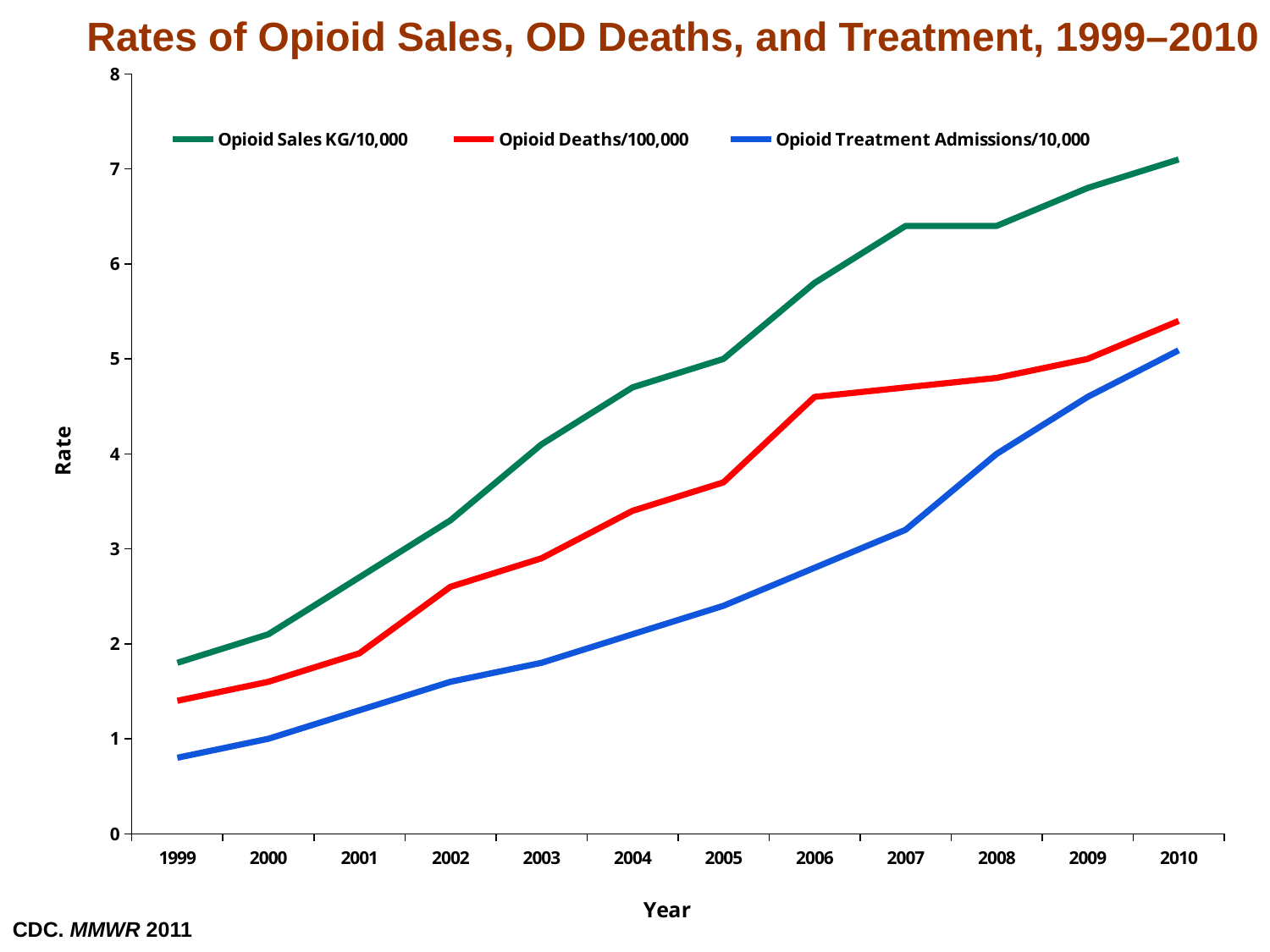
Which series has the lowest value in 1999? Opioid Treatment Admissions/10,000 Which series has the highest value in 2010? Opioid Sales KG/10,000 Which is larger in 2007: Opioid Deaths/100,000 or Opioid Treatment Admissions/10,000? Opioid Deaths/100,000 Is the value for Opioid Sales KG/10,000 in 2010 greater or less than 7? greater Does the Opioid Treatment Admissions/10,000 series rise or fall from 1999 to 2010? rise How many series does the legend list? 3 How many years are plotted along the x axis? 12 Is the value for Opioid Sales KG/10,000 in 1999 greater or less than 2? less What kind of chart is shown on the slide? line chart What is the title of the chart? Rates of Opioid Sales, OD Deaths, and Treatment, 1999–2010 Is the value for Opioid Deaths/100,000 in 2006 greater or less than 4? greater